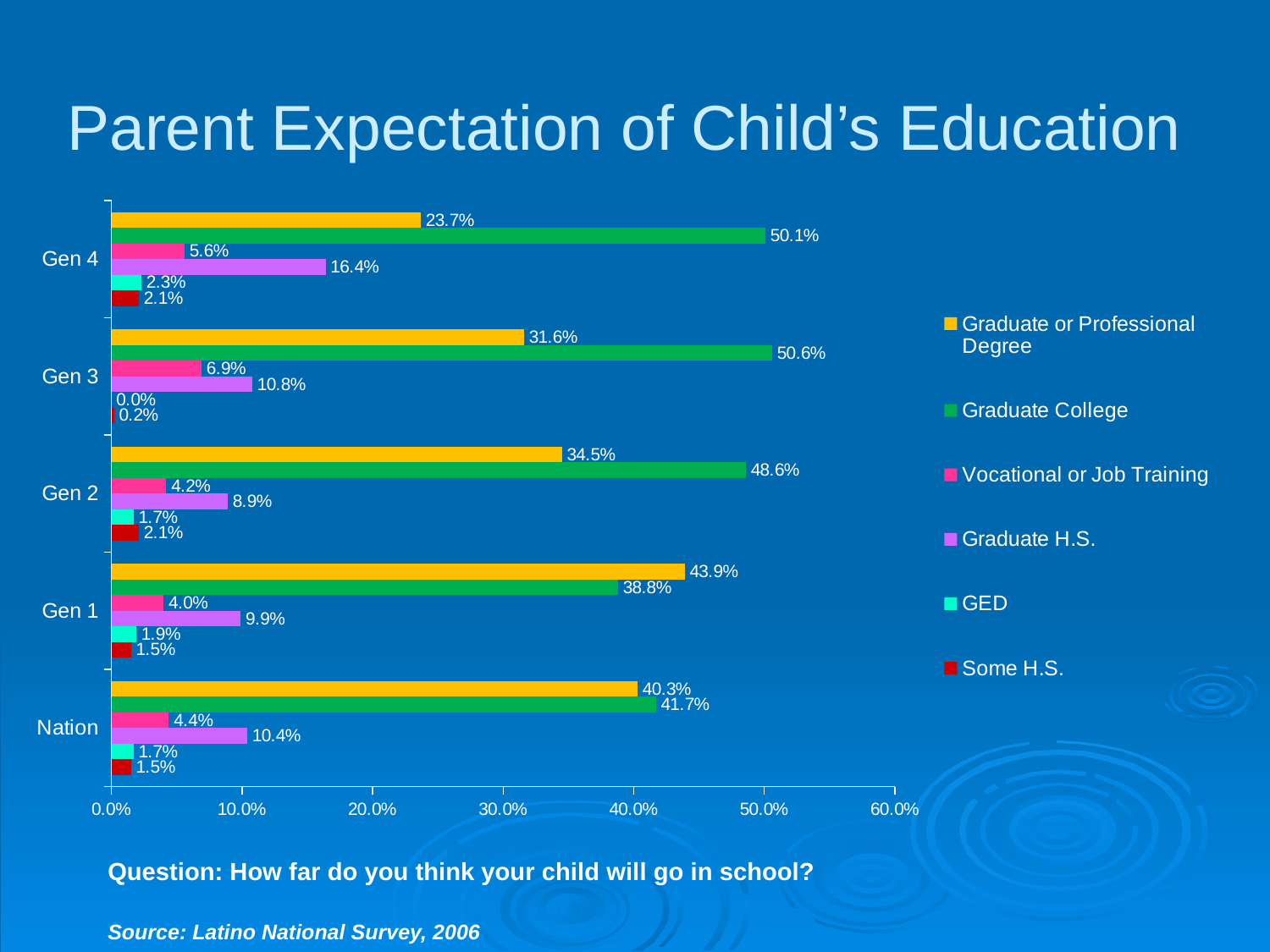
How many series does the legend list? 6 What is the value for Graduate H.S. for the Nation? 10.4% Which category has the highest value for Graduate or Professional Degree? Gen 1 What is the source cited for the chart? Latino National Survey, 2006 What is the value for GED in Gen 3? 0.0% Which is larger in Gen 2: Graduate College or Graduate or Professional Degree? Graduate College Which category has the lowest value for Graduate College? Gen 1 What kind of chart is shown on the slide? Bar chart What is the difference between Graduate College and Graduate or Professional Degree in Gen 4? 26.4% What is the value for Graduate or Professional Degree in Gen 1? 43.9% How many categories are shown on the vertical axis? 5 What is the value for Graduate College in Gen 4? 50.1%